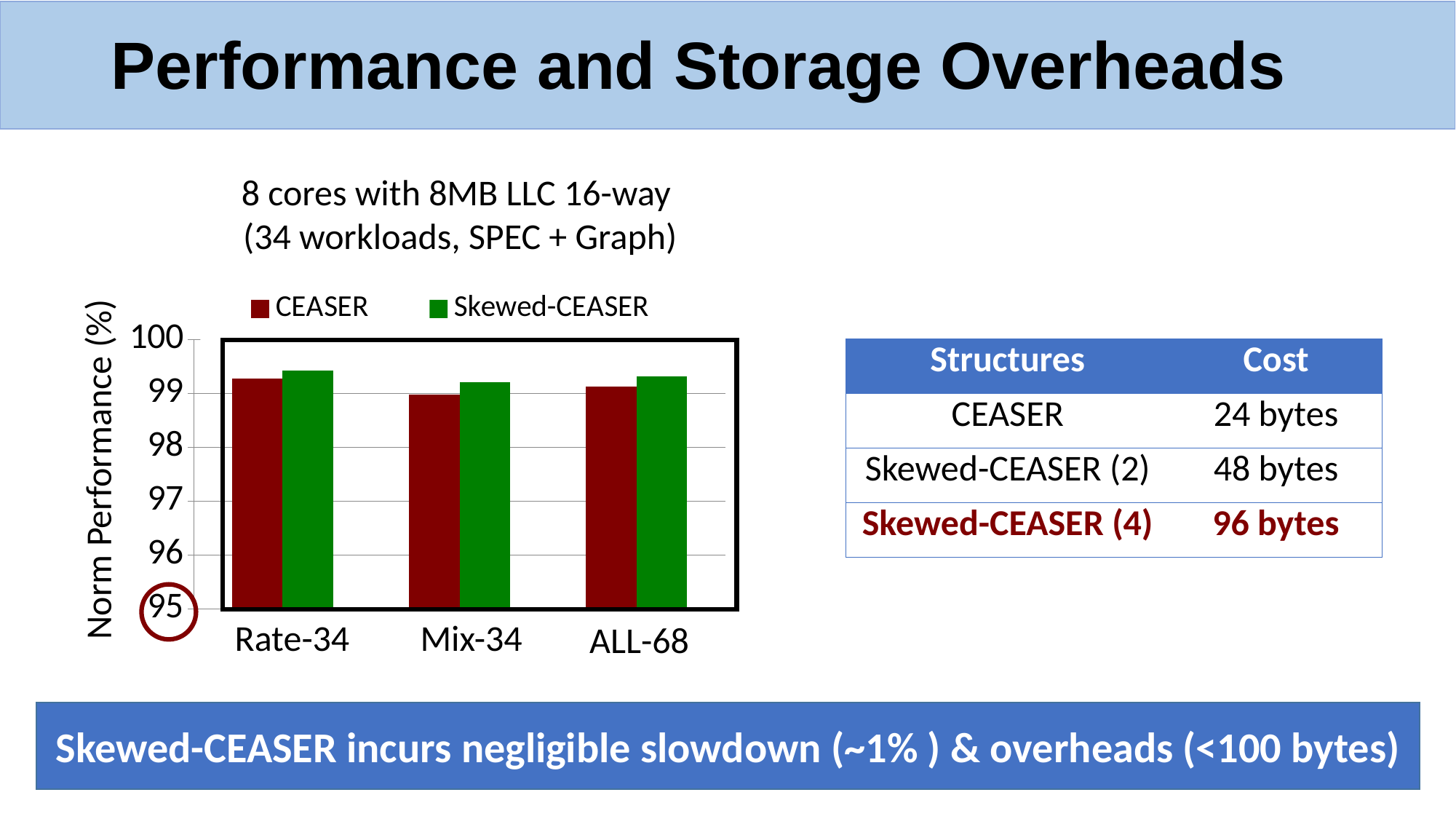
What kind of chart is shown on the slide? bar chart For Rate-34, which series has the higher value, CEASER or Skewed-CEASER? Skewed-CEASER How many categories are shown on the x axis of the chart? 3 Is the Skewed-CEASER value for Rate-34 greater or less than 98? greater For Mix-34, which series has the higher value, CEASER or Skewed-CEASER? Skewed-CEASER How many series does the chart's legend list? 2 Is the Skewed-CEASER value for Mix-34 greater or less than 99? greater Is the CEASER value for Mix-34 greater or less than 98? greater Which series is drawn in green in the chart? Skewed-CEASER Among the CEASER bars, which category has the lowest value? Mix-34 What is the label of the chart's y axis? Norm Performance (%)